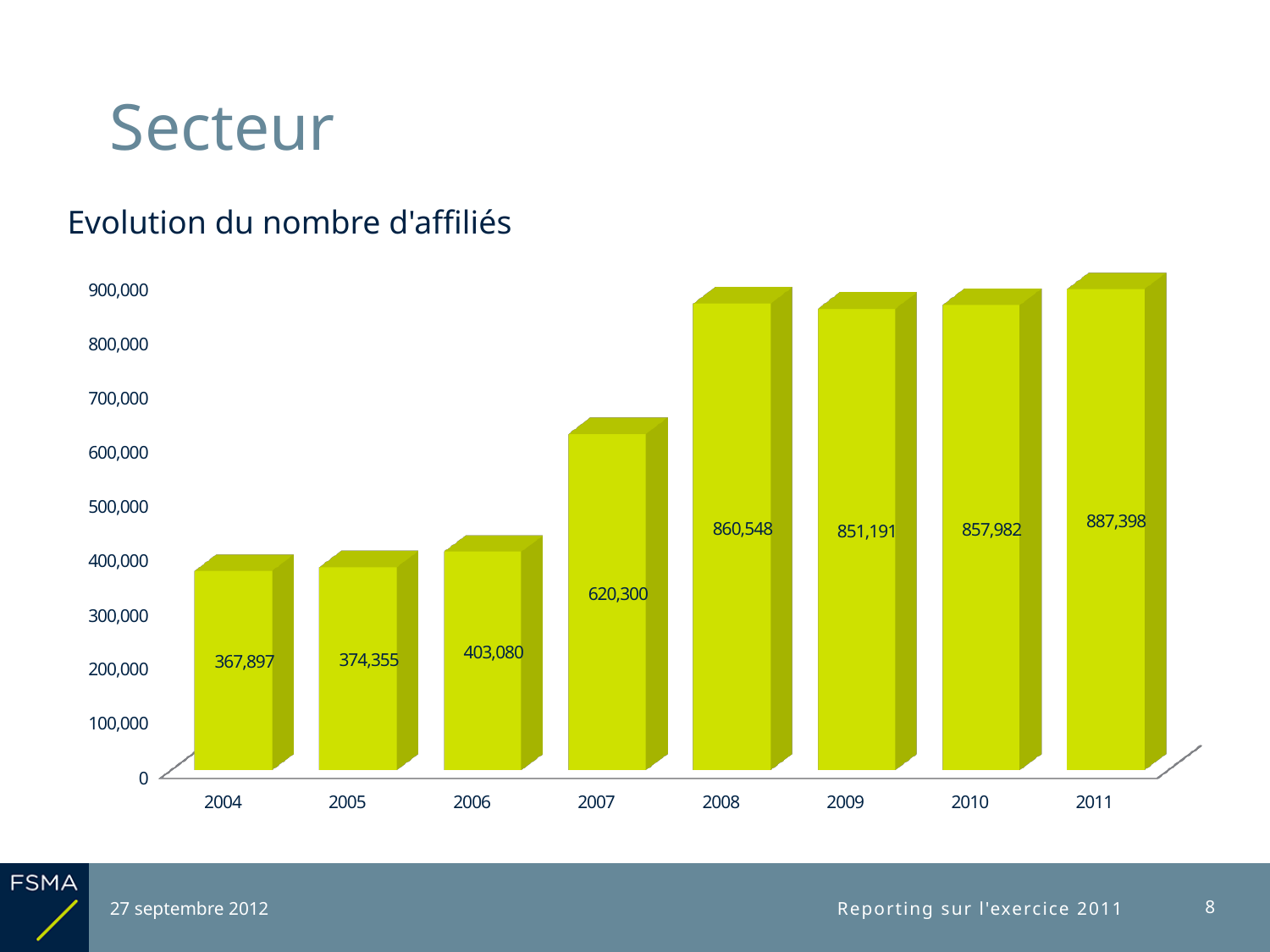
What is the subtitle describing the chart? Evolution du nombre d'affiliés Is the value for 2006 greater or less than 500,000? less What value is shown for 2004? 367,897 How many years are shown on the x axis? 8 What is the number of affiliates shown for 2007? 620,300 Which year has the lowest number of affiliates? 2004 What is the difference between the values for 2008 and 2007? 240,248 Which is larger, the value for 2008 or the value for 2009? 2008 What kind of chart is shown on the slide? bar chart What value is shown for 2011? 887,398 Which year has the highest number of affiliates? 2011 What is the difference between the values for 2011 and 2010? 29,416